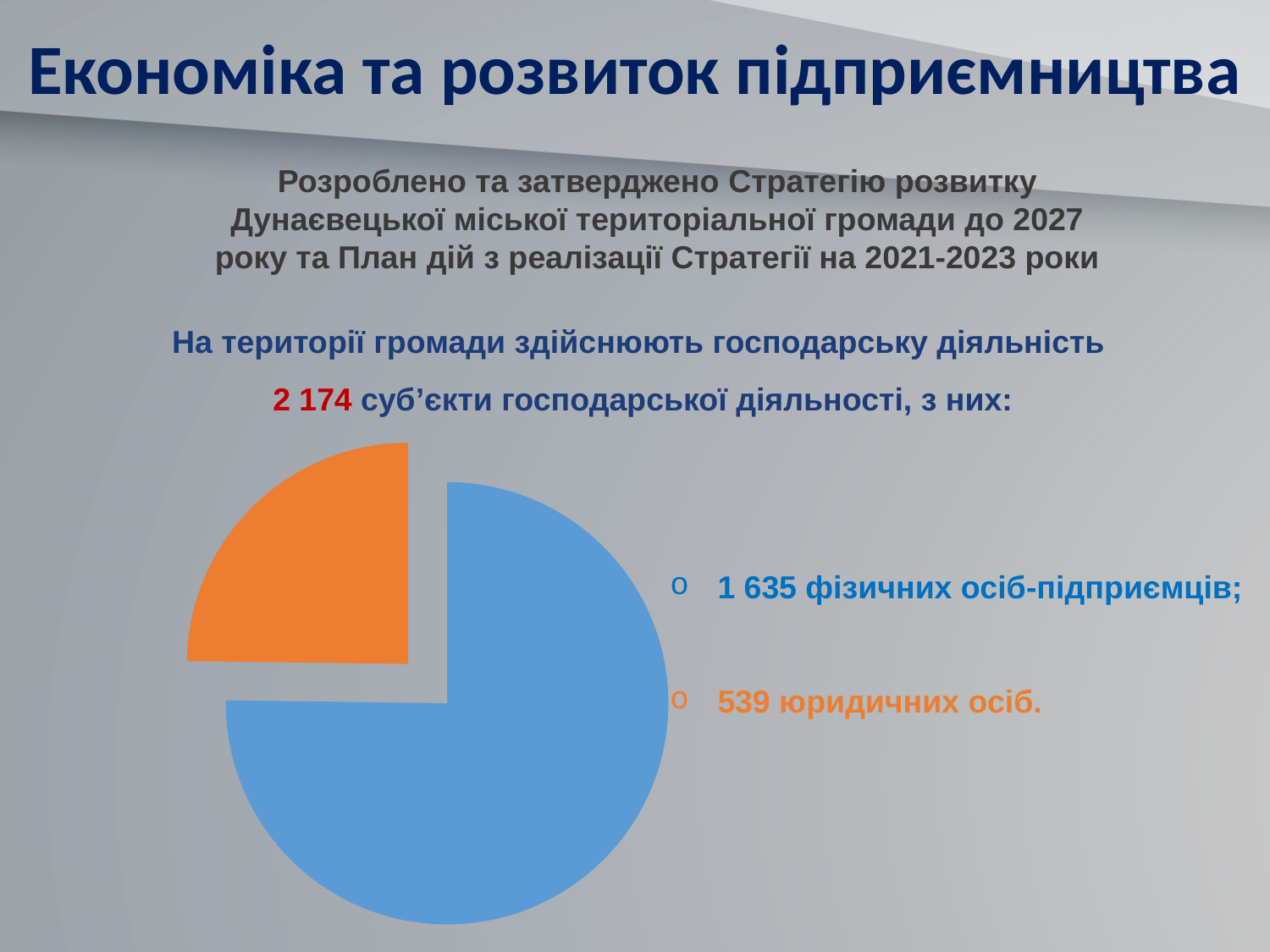
Which is larger: the number of фізичних осіб-підприємців or the number of юридичних осіб? фізичних осіб-підприємців What colour is the slice representing юридичних осіб? orange What is the total number of суб'єктів господарської діяльності represented by the pie chart? 2 174 What is the difference between the number of фізичних осіб-підприємців and the number of юридичних осіб? 1 096 Which category has the larger slice of the pie chart? фізичні особи-підприємці How many фізичних осіб-підприємців are there according to the slide? 1 635 Which category has the smaller slice of the pie chart? юридичні особи How many slices does the pie chart have? 2 How many юридичних осіб are there according to the slide? 539 What colour is the slice representing фізичних осіб-підприємців? blue What kind of chart is shown on the slide? pie chart